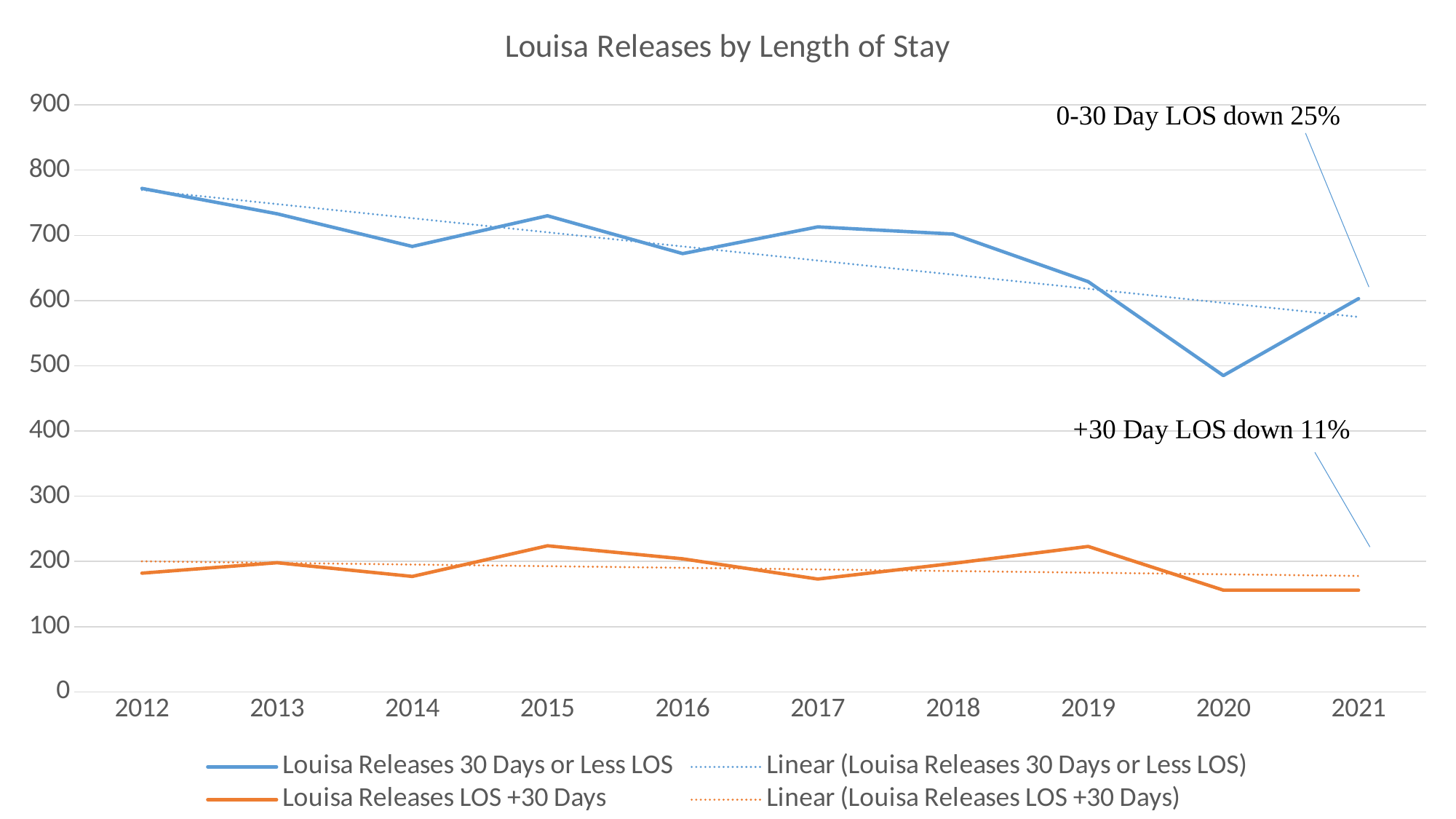
In which year is the value for Louisa Releases 30 Days or Less LOS highest? 2012 Is the value for Louisa Releases LOS +30 Days in 2015 greater or less than 200? greater What kind of chart is shown on the slide? Line chart Is the value for Louisa Releases 30 Days or Less LOS in 2020 greater or less than 500? less How many years are plotted along the x axis? 10 Which year has the larger value for Louisa Releases LOS +30 Days, 2017 or 2019? 2019 What is the title of the chart? Louisa Releases by Length of Stay Is the value for Louisa Releases LOS +30 Days in 2020 greater or less than 200? less In which year is the value for Louisa Releases 30 Days or Less LOS lowest? 2020 Does the Louisa Releases 30 Days or Less LOS series rise or fall overall from 2012 to 2021? Fall How many entries does the legend list? 4